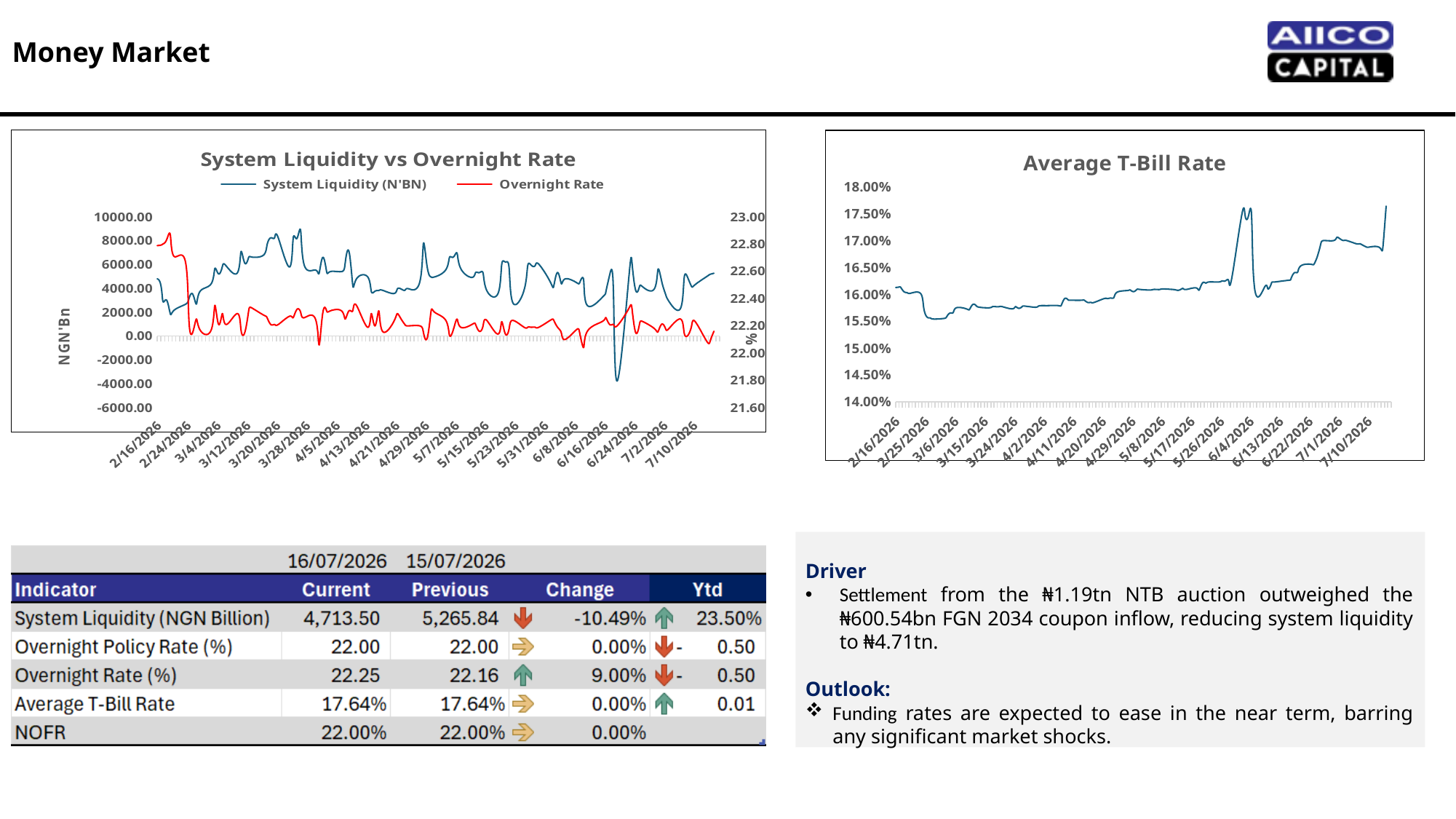
What is the highest tick shown on the right-hand axis of the "System Liquidity vs Overnight Rate" chart? 23.00 In the "System Liquidity vs Overnight Rate" chart, is the lowest value of System Liquidity greater or less than -2000.00? less In the "Average T-Bill Rate" chart, is the final value at the right end of the series greater or less than 17.00%? greater In the "Average T-Bill Rate" chart, is the peak value near 6/4/2026 greater or less than 17.00%? greater How many series does the legend of the "System Liquidity vs Overnight Rate" chart list? 2 What are the two series named in the legend of the "System Liquidity vs Overnight Rate" chart? System Liquidity (N'BN) and Overnight Rate What kind of chart is the "System Liquidity vs Overnight Rate" chart? line chart In the "Average T-Bill Rate" chart, does the rate overall rise or fall from the start of the series to the end? rise What kind of chart is the "Average T-Bill Rate" chart? line chart